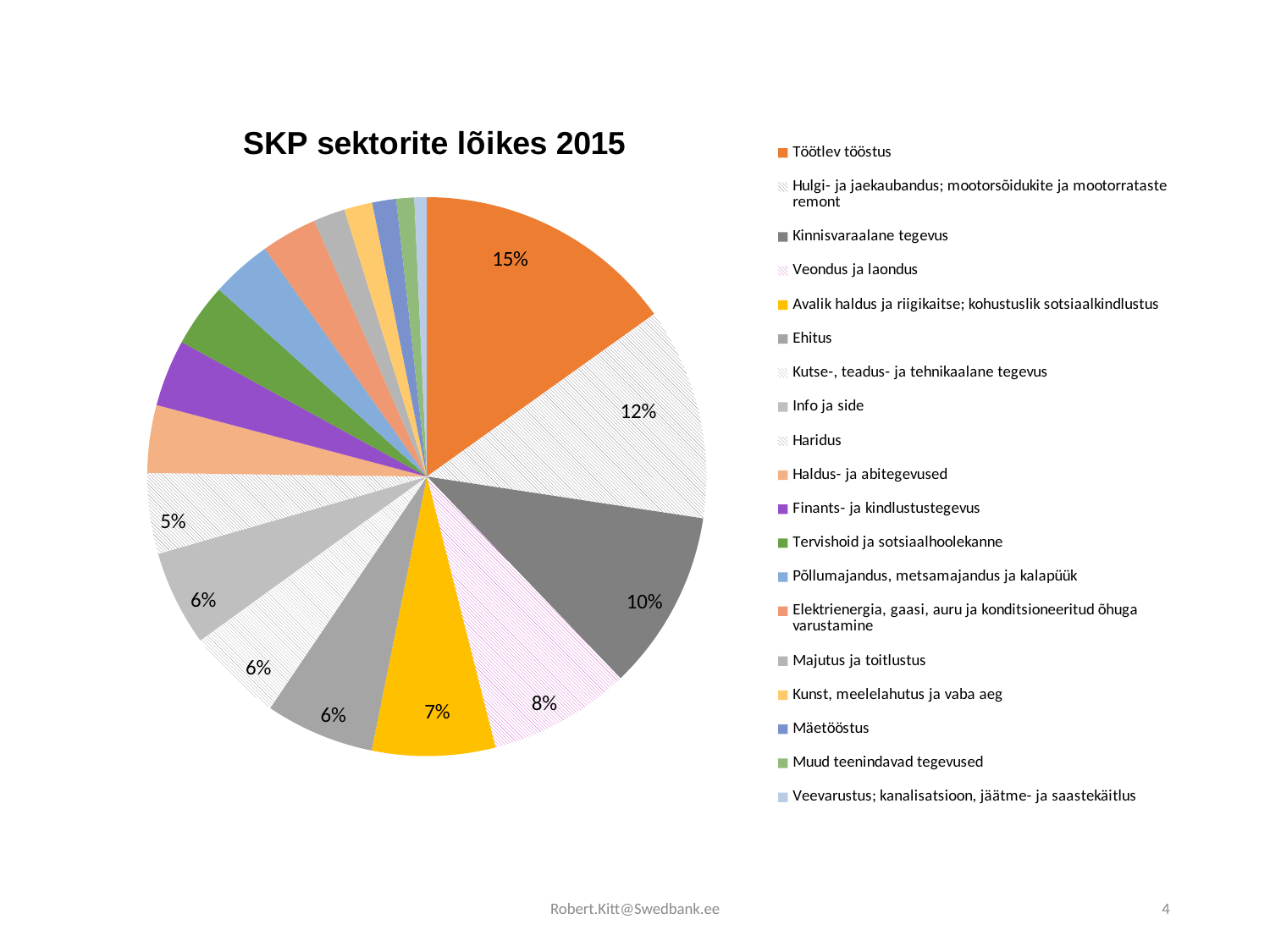
What type of chart is shown on the slide? pie chart What share of the pie does Hulgi- ja jaekaubandus; mootorsõidukite ja mootorrataste remont have? 12% Which sector has the largest share of the pie? Töötlev tööstus Which is larger, the share for Veondus ja laondus or the share for Avalik haldus ja riigikaitse; kohustuslik sotsiaalkindlustus? Veondus ja laondus What is the title of the chart? SKP sektorite lõikes 2015 What share of the pie does Kinnisvaraalane tegevus have? 10% What share of the pie does Töötlev tööstus have? 15% What share of the pie does Veondus ja laondus have? 8% How many sectors does the legend list? 19 What share of the pie does Avalik haldus ja riigikaitse; kohustuslik sotsiaalkindlustus have? 7% What is the difference in percentage points between Töötlev tööstus and Kinnisvaraalane tegevus? 5 What share of the pie does Haridus have? 5%